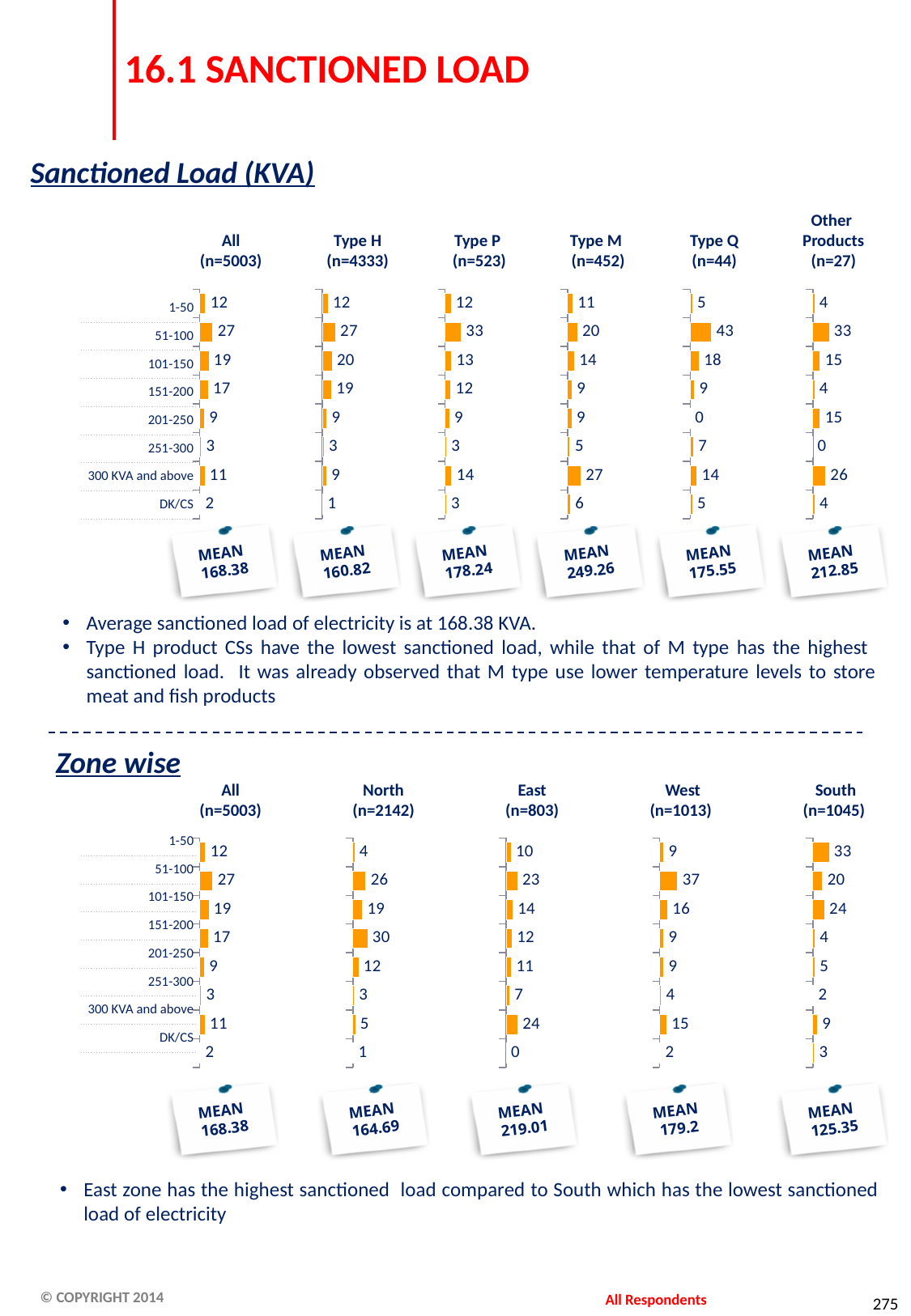
In the Sanctioned Load (KVA) section, which is larger in the Other Products (n=27) chart: the 51-100 value or the 300 KVA and above value? 51-100 In the Zone wise section, what is the value for the 151-200 category in the North (n=2142) chart? 30 In the Sanctioned Load (KVA) section, which category has the lowest value in the Type M (n=452) chart? 251-300 In the Sanctioned Load (KVA) section, what is the value for the 51-100 category in the Type Q (n=44) chart? 43 What kind of chart is used in the Zone wise section? Bar chart In the Sanctioned Load (KVA) section, what is the MEAN shown below the Type M (n=452) chart? 249.26 How many separate charts are shown in the Zone wise section? 5 In the Zone wise section, what is the difference between the 300 KVA and above value and the 151-200 value in the East (n=803) chart? 12 In the Sanctioned Load (KVA) section, which category has the highest value in the Type P (n=523) chart? 51-100 How many categories are plotted in each chart of the Sanctioned Load (KVA) section? 8 In the Zone wise section, what is the value for the 1-50 category in the South (n=1045) chart? 33 In the Zone wise section, which category has the highest value in the West (n=1013) chart? 51-100